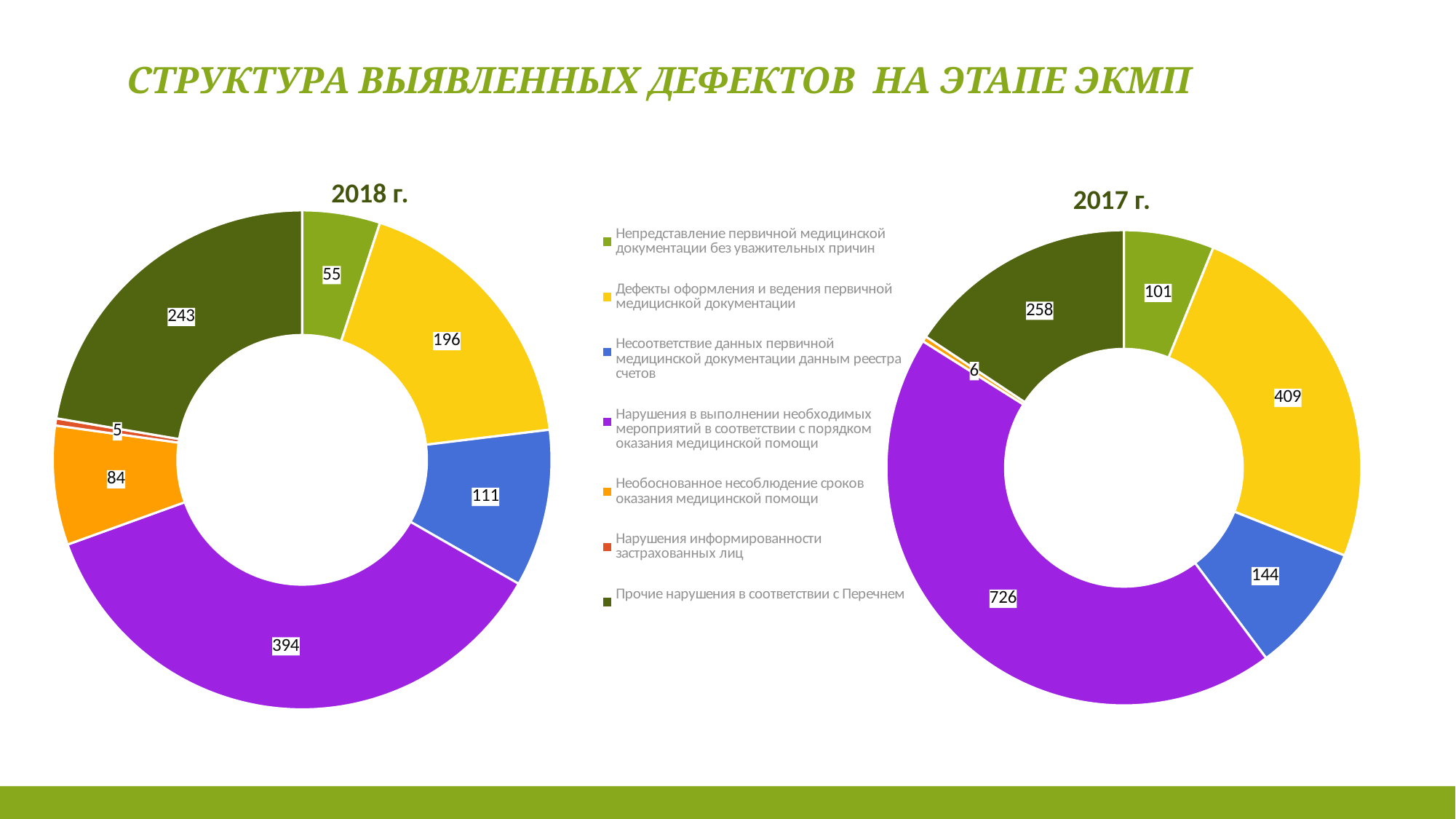
In the 2018 г. chart, what share of the total does the slice with value 394 represent? 36.2% In the 2018 г. chart, what is the value for Нарушения в выполнении необходимых мероприятий в соответствии с порядком оказания медицинской помощи? 394 In the 2017 г. chart, what is the difference between the values 726 and 409? 317 In the 2017 г. chart, which category has the largest slice? Нарушения в выполнении необходимых мероприятий в соответствии с порядком оказания медицинской помощи What type of chart is used on this slide? Doughnut (pie) chart Which is larger: the value for Несоответствие данных первичной медицинской документации данным реестра счетов in 2017 г. or in 2018 г.? 2017 г. (144) In the 2018 г. chart, what is the difference between Прочие нарушения в соответствии с Перечнем and Дефекты оформления и ведения первичной медицинской документации? 47 In the 2018 г. chart, which category has the smallest slice? Нарушения информированности застрахованных лиц In the 2018 г. chart, what is the value for Необоснованное несоблюдение сроков оказания медицинской помощи? 84 How many slices does the 2018 г. chart have? 7 How many entries does the legend list? 7 In the 2017 г. chart, what is the value for Дефекты оформления и ведения первичной медицинской документации? 409